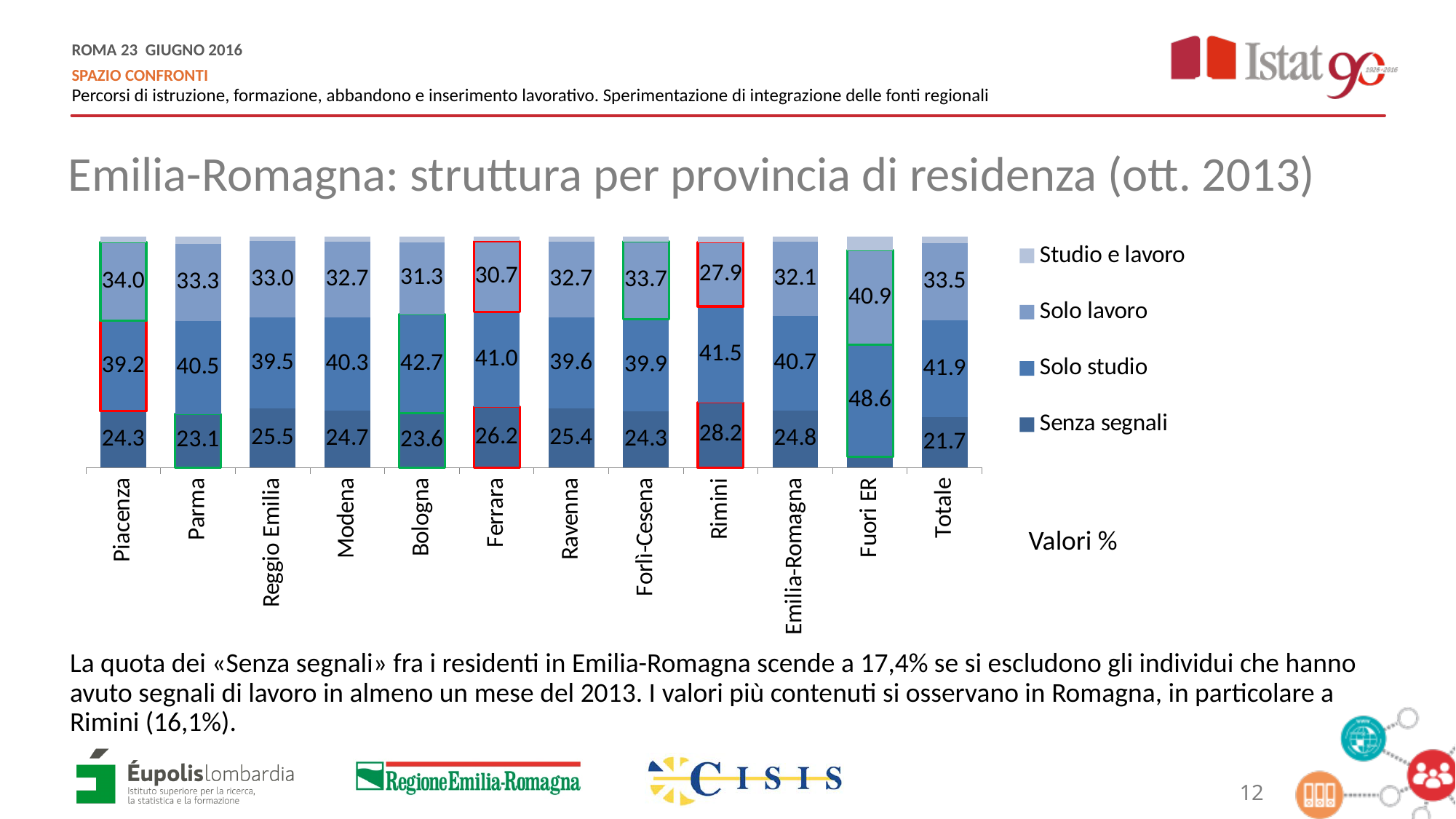
Which category has the lowest value for "Solo lavoro"? Rimini What is the value of "Senza segnali" for Rimini? 28.2 Which has the larger "Solo lavoro" value, Piacenza or Ferrara? Piacenza What is the difference between the "Senza segnali" values for Rimini and Parma? 5.1 Which category has the highest value for "Senza segnali"? Rimini How many series does the legend list? 4 How many categories are shown along the x axis? 12 What is the value of "Solo studio" for Totale? 41.9 What is the value of "Solo lavoro" for Fuori ER? 40.9 What kind of chart is shown on the slide? Stacked bar chart What is the value of "Solo studio" for Bologna? 42.7 Which category has the highest value for "Solo studio"? Fuori ER